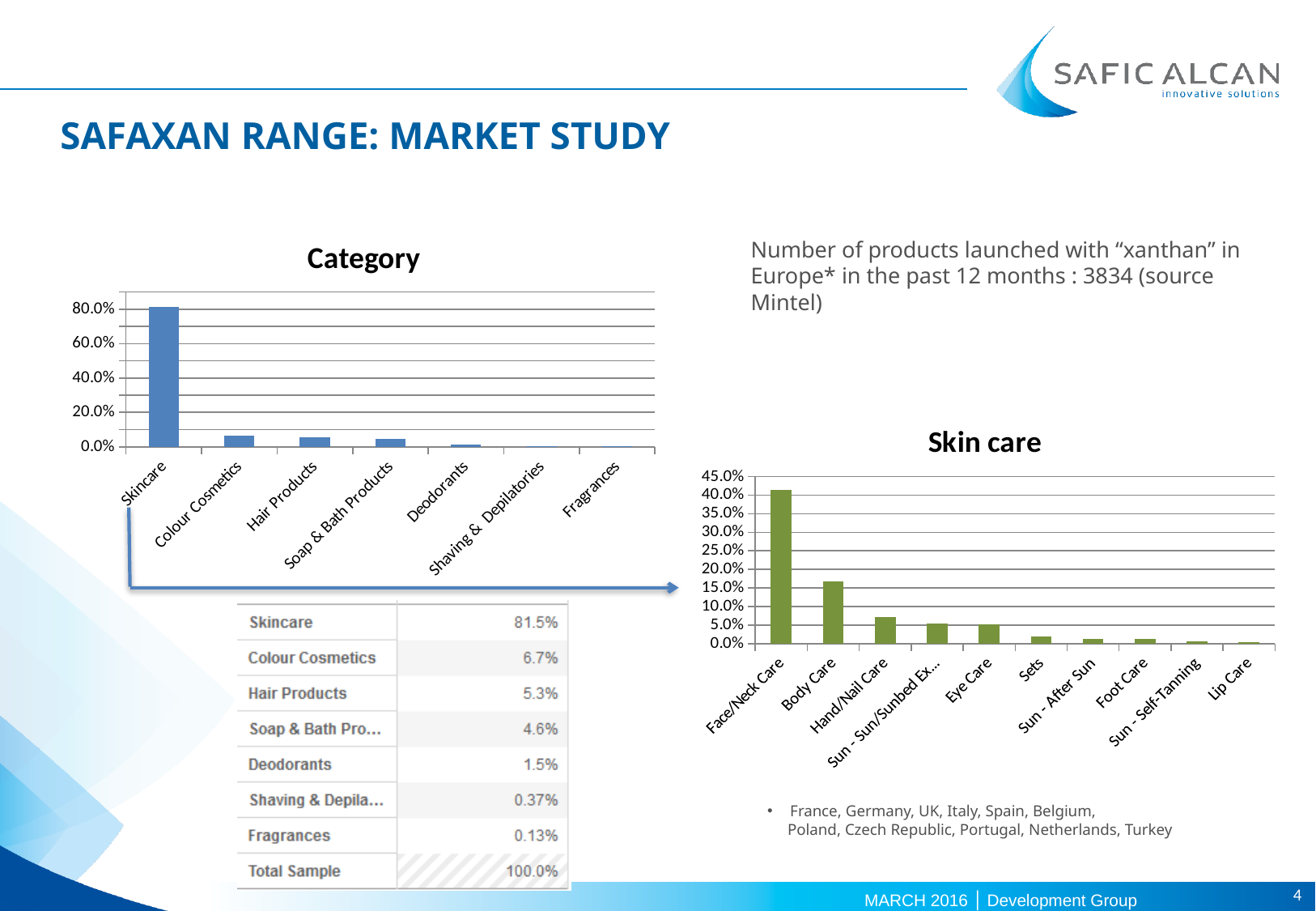
On the Category chart, which category has the highest value? Skincare How many categories are shown on the Category chart? 7 On the Skin care chart, is the value for Face/Neck Care greater or less than 35.0%? greater On the Category chart, what is the value for Skincare? 81.5% On the Skin care chart, is the value for Body Care greater or less than 20.0%? less On the Category chart, what is the value for Colour Cosmetics? 6.7% How many categories are shown on the Skin care chart? 10 What kind of chart is the Skin care chart? Bar chart On the Category chart, what is the value for Fragrances? 0.13% On the Category chart, which category has the lowest value? Fragrances On the Category chart, which is larger, Soap & Bath Products or Deodorants? Soap & Bath Products On the Category chart, what is the difference between Colour Cosmetics and Hair Products? 1.4%